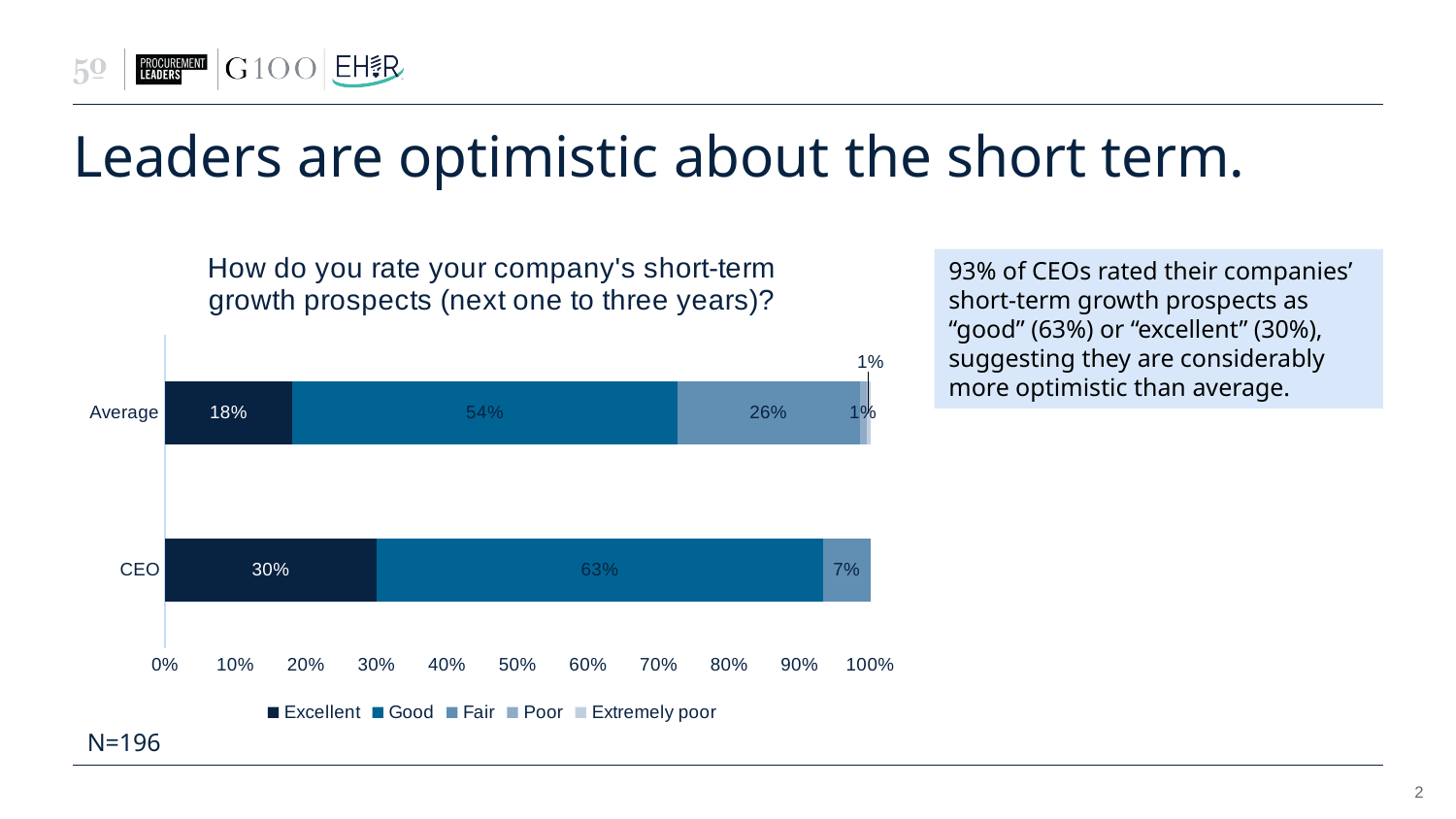
What is the title of the chart? How do you rate your company's short-term growth prospects (next one to three years)? What is the combined "Excellent" and "Good" share for CEO? 93% How many series does the legend list? 5 Which category has the larger "Excellent" value, CEO or Average? CEO What is the "Excellent" value for CEO? 30% What is the "Good" value for Average? 54% What is the difference between the "Good" values for CEO and Average? 9% What is the "Excellent" value for Average? 18% What kind of chart is shown on the slide? Stacked bar chart How many categories are shown on the chart? 2 What is the "Fair" value for CEO? 7% What is the "Fair" value for Average? 26%